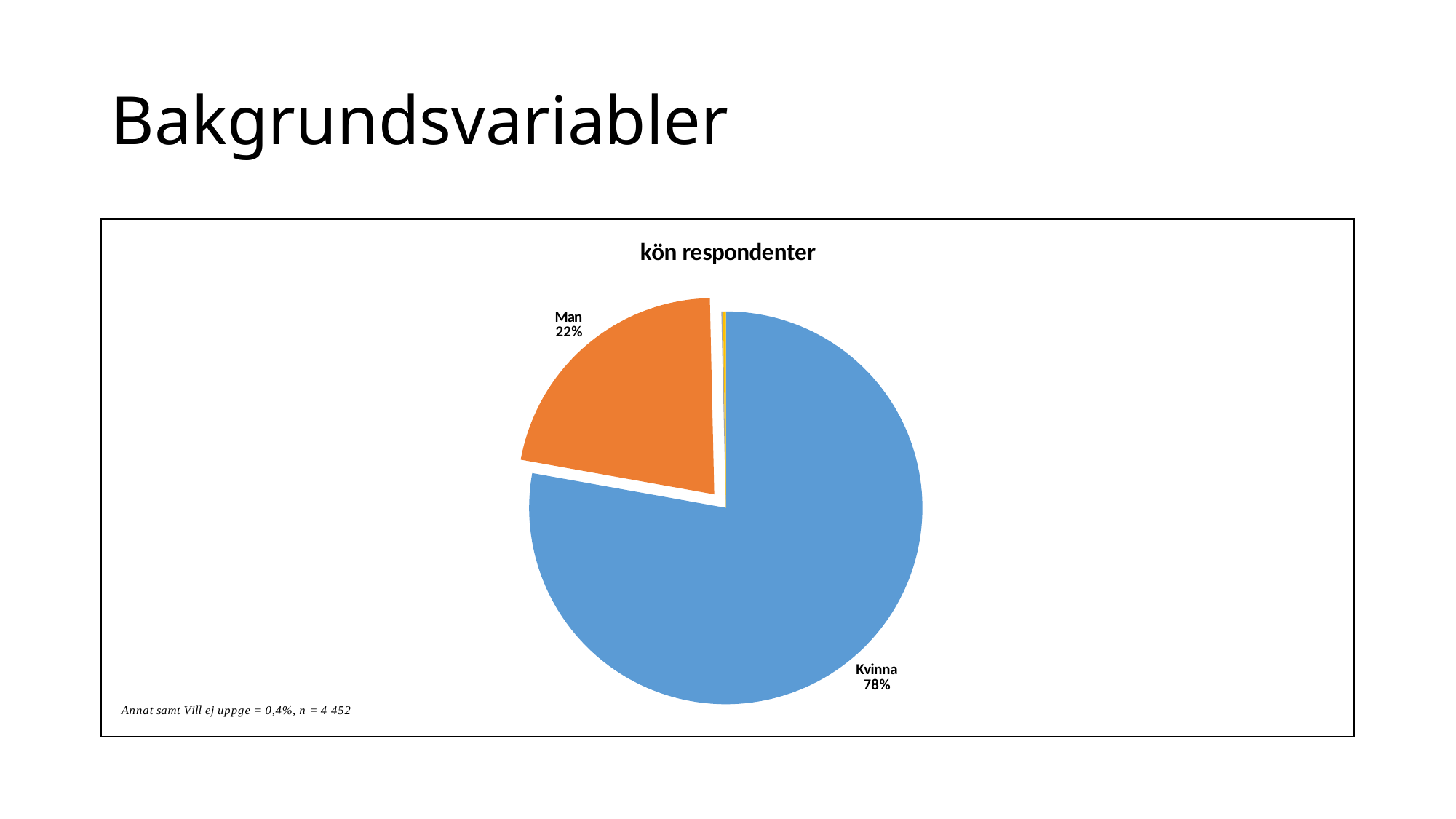
What is the value of n given in the note on the chart? 4 452 What is the title of the chart? kön respondenter What share of respondents are Man? 22% According to the note on the chart, what is the combined share for Annat and Vill ej uppge? 0,4% What colour is the Kvinna slice? blue Is the share for Kvinna greater or less than 50%? greater Which labelled category has the smaller slice, Man or Kvinna? Man Which category has the largest slice of the pie? Kvinna What share of respondents are Kvinna? 78% What type of chart is shown on the slide? pie chart What is the difference in percentage points between the Kvinna and Man slices? 56